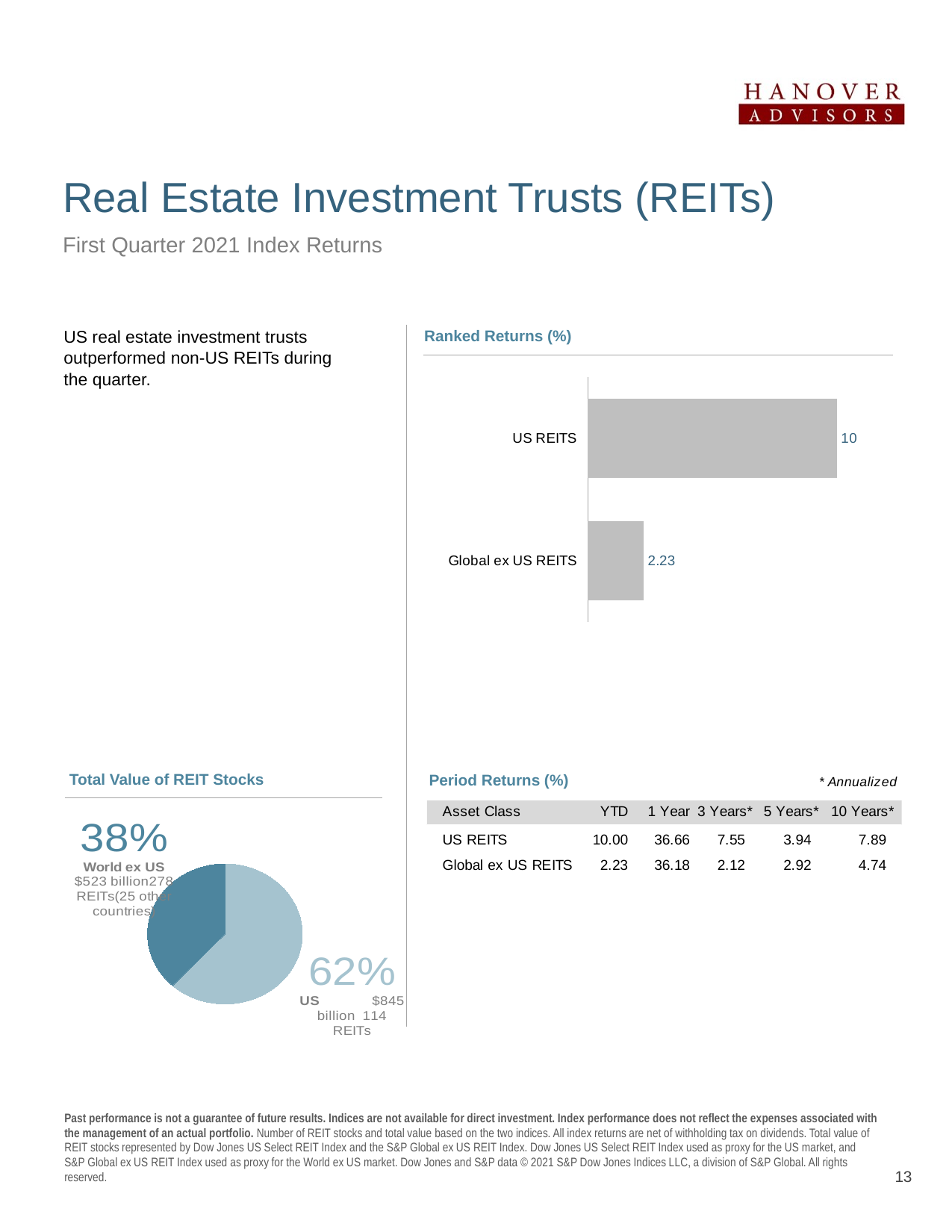
In the Ranked Returns (%) chart, which category has the lowest value? Global ex US REITS In the Total Value of REIT Stocks chart, how many slices does the pie have? 2 In the Total Value of REIT Stocks chart, what share of the pie does World ex US represent? 38% In the Ranked Returns (%) chart, which category has the highest value? US REITS What kind of chart is the Total Value of REIT Stocks chart? Pie chart In the Total Value of REIT Stocks chart, which slice is larger, US or World ex US? US In the Total Value of REIT Stocks chart, what share of the pie does US represent? 62% What kind of chart is the Ranked Returns (%) chart? Bar chart In the Ranked Returns (%) chart, what is the difference between the US REITS and Global ex US REITS values? 7.77 In the Ranked Returns (%) chart, what is the value for US REITS? 10 In the Ranked Returns (%) chart, how many categories are plotted? 2 In the Ranked Returns (%) chart, what is the value for Global ex US REITS? 2.23